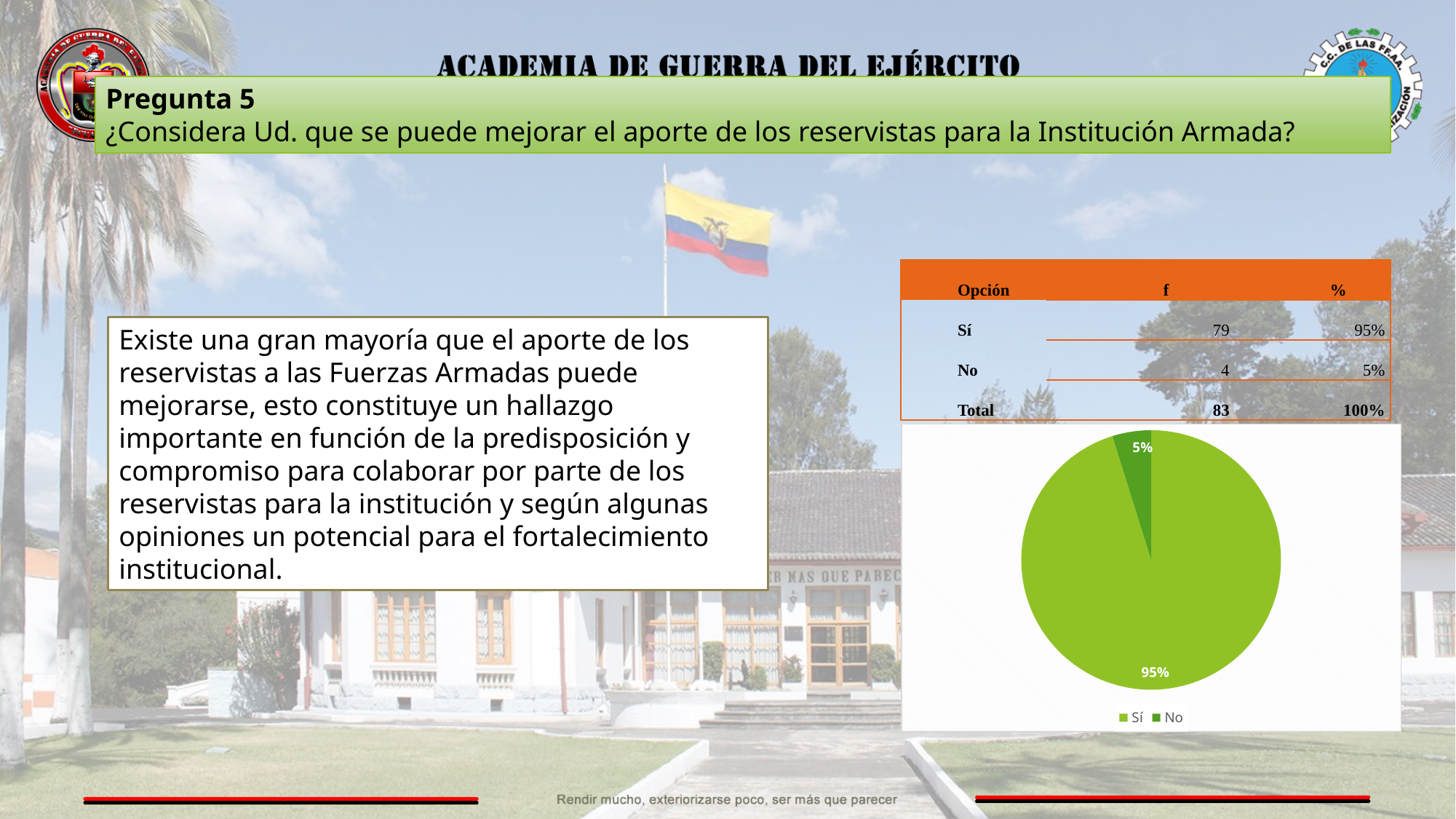
What is the difference in percentage points between the 'Sí' and 'No' slices? 90 Which slice of the pie chart is the smallest? No How many slices does the pie chart have? 2 How many entries does the legend of the pie chart list? 2 What percentage does the 'Sí' slice of the pie chart show? 95% What colour is the 'Sí' slice of the pie chart? light green Which slice of the pie chart is the largest? Sí What percentage does the 'No' slice of the pie chart show? 5% Which is larger in the pie chart, 'Sí' or 'No'? Sí What kind of chart is shown on the slide? pie chart What share of the pie does the 'No' slice represent? 5% What are the two legend entries of the pie chart? Sí and No